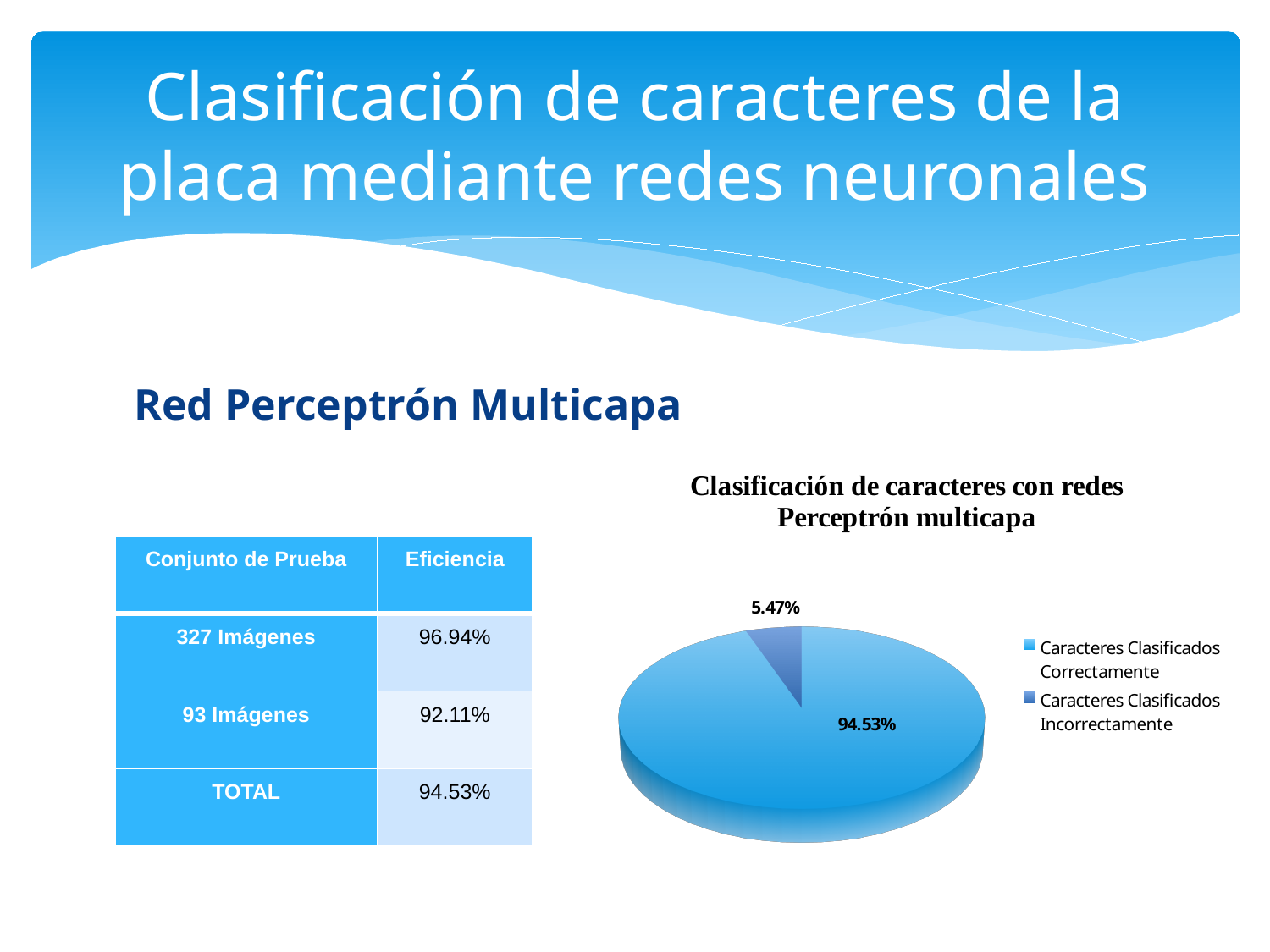
What is the total of the two slice labels in the pie chart? 100% Which slice of the pie chart is the largest? Caracteres Clasificados Correctamente What share of the pie is labelled for Caracteres Clasificados Incorrectamente? 5.47% What is the difference between the Caracteres Clasificados Correctamente share and the Caracteres Clasificados Incorrectamente share? 89.06% Which is larger in the pie chart: Caracteres Clasificados Correctamente or Caracteres Clasificados Incorrectamente? Caracteres Clasificados Correctamente How many slices does the pie chart have? 2 What is the title of the pie chart? Clasificación de caracteres con redes Perceptrón multicapa What share of the pie is labelled for Caracteres Clasificados Correctamente? 94.53% What kind of chart is shown on the slide? Pie chart Which slice of the pie chart is the smallest? Caracteres Clasificados Incorrectamente How many entries does the legend of the pie chart list? 2